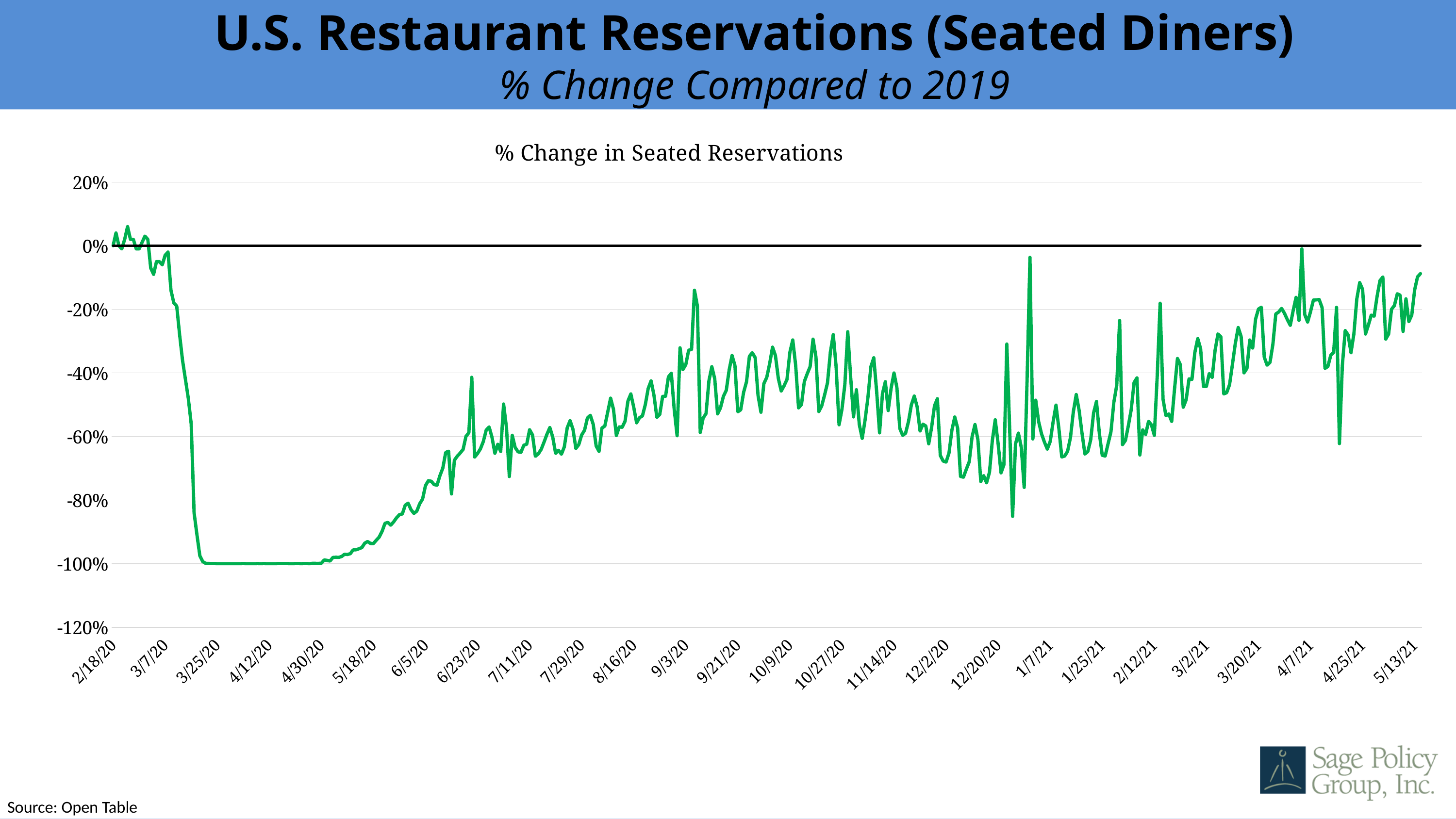
Does the line rise or fall between 4/30/20 and 6/23/20? rise Is the value for 4/12/20 greater or less than -80%? less Is the value for 5/13/21 greater or less than -40%? greater Which date has the larger value, 4/12/20 or 9/21/20? 9/21/20 Is the value for 12/20/20 greater or less than -40%? less What is the title printed above the chart's plot area? % Change in Seated Reservations What source is cited for the chart? Open Table How many date labels are shown on the x axis? 26 What is the lowest value the line reaches? -100% Does the line rise or fall between 3/7/20 and 3/25/20? fall What kind of chart is shown on the slide? line chart